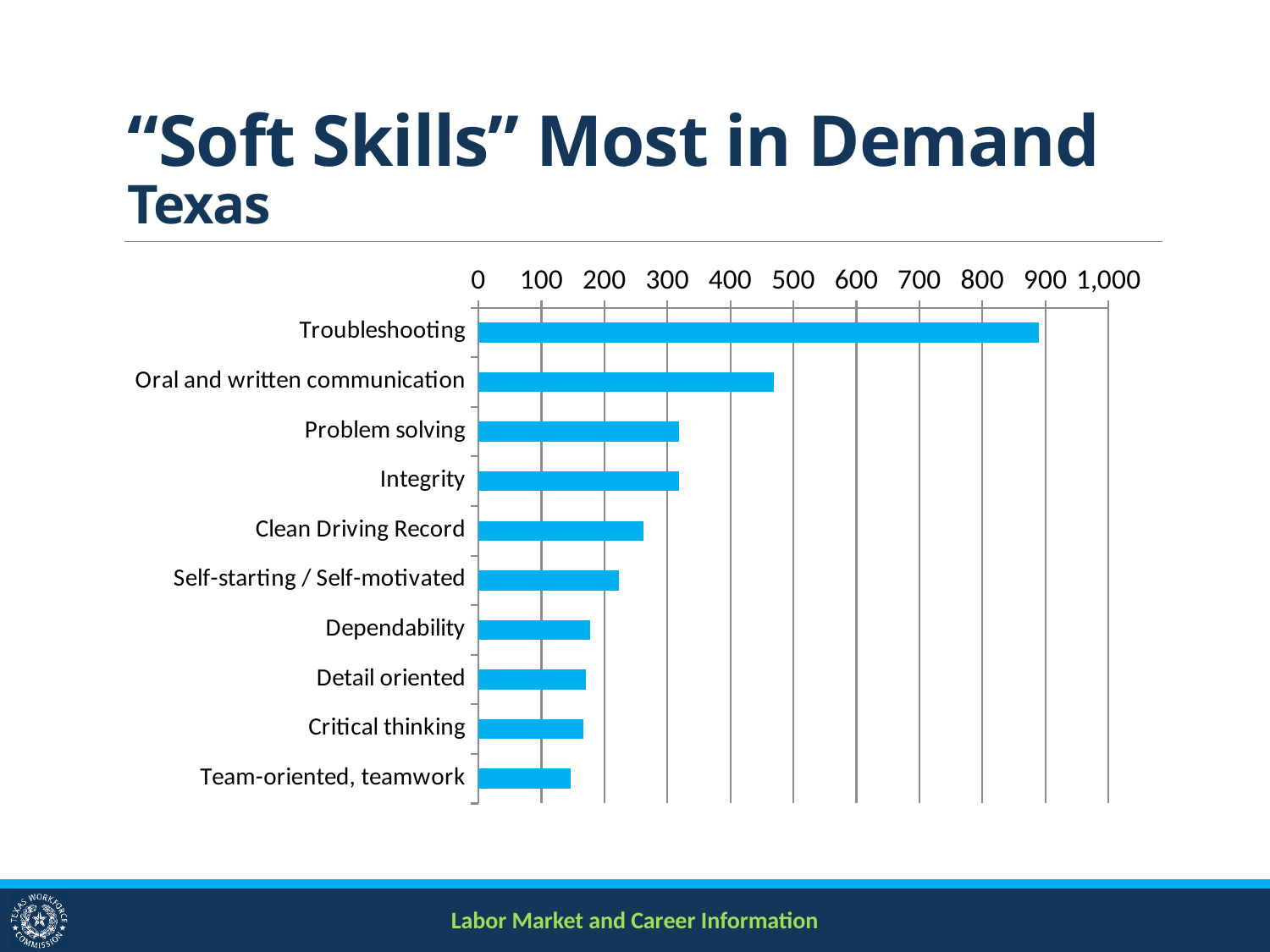
Which soft skill has the lowest value in the chart? Team-oriented, teamwork What is the highest value shown on the horizontal axis of the chart? 1,000 Is the value for Team-oriented, teamwork greater or less than 200? less Is the value for Oral and written communication greater or less than 500? less What is the title of the slide containing the chart? "Soft Skills" Most in Demand Texas Is the value for Clean Driving Record greater or less than 200? greater What kind of chart is shown on the slide? bar chart Which has a larger value, Self-starting / Self-motivated or Dependability? Self-starting / Self-motivated How many soft skills (categories) are plotted in the chart? 10 Which soft skill has the highest value in the chart? Troubleshooting Which has a larger value, Oral and written communication or Problem solving? Oral and written communication